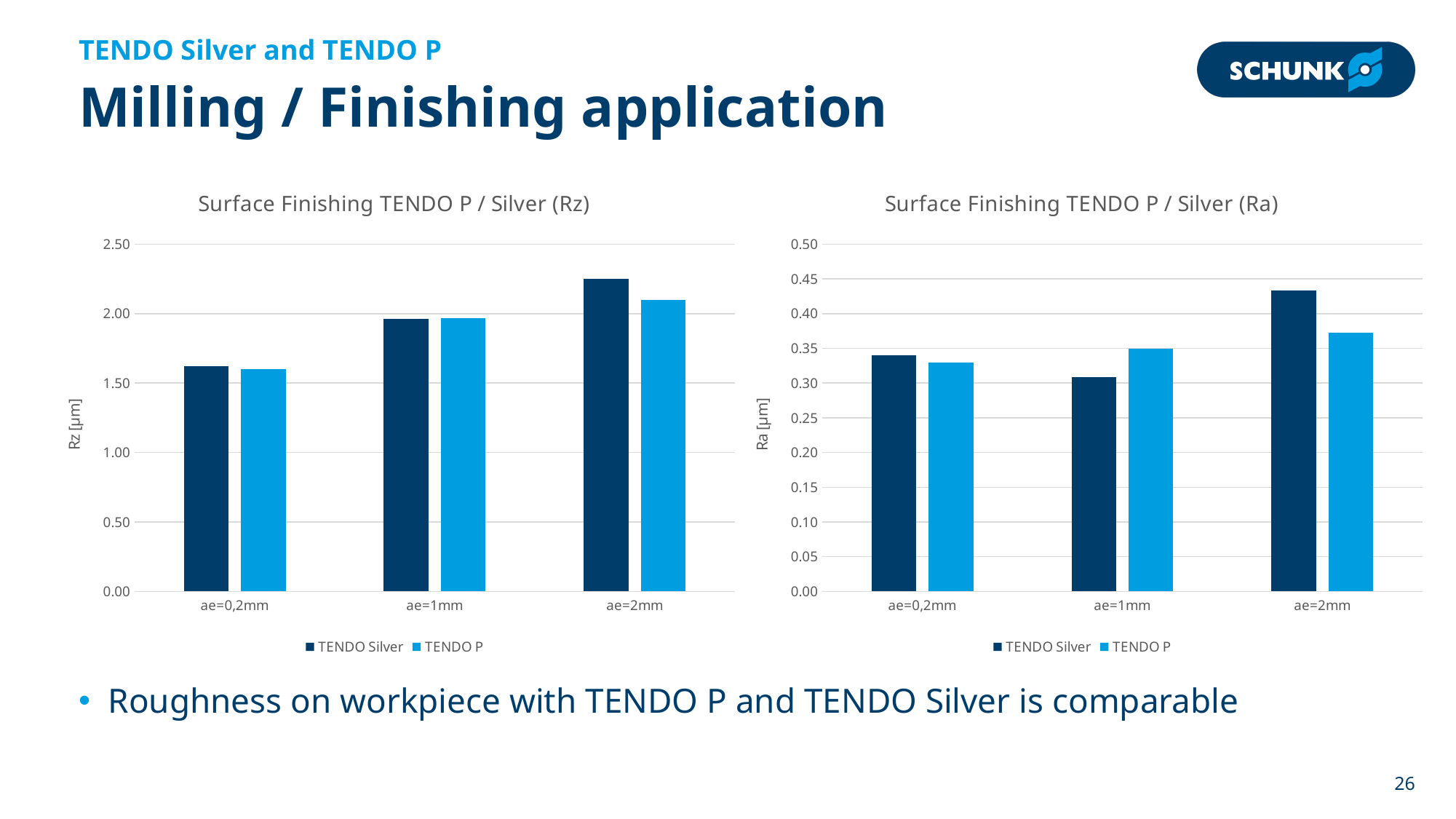
In the 'Surface Finishing TENDO P / Silver (Ra)' chart, how many categories are shown on the x axis? 3 In the 'Surface Finishing TENDO P / Silver (Ra)' chart, which category has the lowest TENDO Silver value? ae=1mm In the 'Surface Finishing TENDO P / Silver (Rz)' chart, is the TENDO Silver value for ae=2mm greater or less than 2.00? greater What kind of chart is the 'Surface Finishing TENDO P / Silver (Rz)' chart? bar chart In the 'Surface Finishing TENDO P / Silver (Rz)' chart, how many series does the legend list? 2 In the 'Surface Finishing TENDO P / Silver (Rz)' chart, which series has the larger value at ae=2mm, TENDO Silver or TENDO P? TENDO Silver In the 'Surface Finishing TENDO P / Silver (Ra)' chart, which series has the larger value at ae=2mm, TENDO Silver or TENDO P? TENDO Silver In the 'Surface Finishing TENDO P / Silver (Rz)' chart, is the TENDO P value for ae=0,2mm greater or less than 2.00? less In the 'Surface Finishing TENDO P / Silver (Ra)' chart, is the TENDO Silver value for ae=2mm greater or less than 0.40? greater In the 'Surface Finishing TENDO P / Silver (Rz)' chart, which category has the highest TENDO Silver value? ae=2mm What is the y-axis label of the 'Surface Finishing TENDO P / Silver (Ra)' chart? Ra [µm] In the 'Surface Finishing TENDO P / Silver (Rz)' chart, do the TENDO Silver values rise or fall from ae=0,2mm to ae=2mm? rise